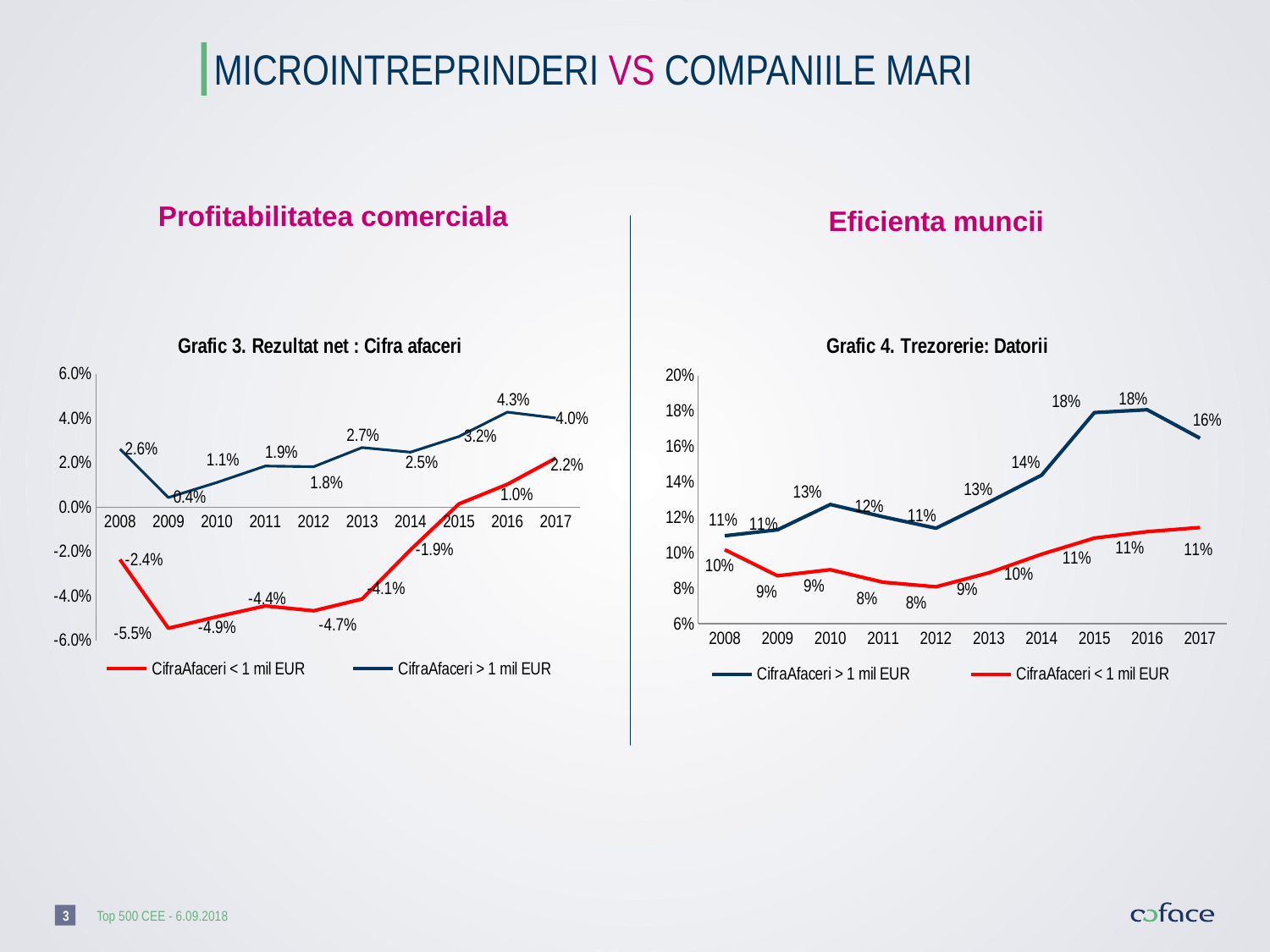
In the chart 'Grafic 4. Trezorerie: Datorii', what is the value for CifraAfaceri > 1 mil EUR in 2015? 18% In the chart 'Grafic 3. Rezultat net : Cifra afaceri', how many series does the legend list? 2 In the chart 'Grafic 4. Trezorerie: Datorii', what is the value for CifraAfaceri < 1 mil EUR in 2012? 8% In the chart 'Grafic 4. Trezorerie: Datorii', which series has the higher value in 2014? CifraAfaceri > 1 mil EUR In the chart 'Grafic 4. Trezorerie: Datorii', what is the difference between the two series in 2016? 7% What kind of chart is 'Grafic 3. Rezultat net : Cifra afaceri'? Line chart How many years are shown on the x axis of the chart 'Grafic 4. Trezorerie: Datorii'? 10 In the chart 'Grafic 3. Rezultat net : Cifra afaceri', which year has the lowest value for CifraAfaceri < 1 mil EUR? 2009 In the chart 'Grafic 3. Rezultat net : Cifra afaceri', what is the value for CifraAfaceri > 1 mil EUR in 2016? 4.3% In the chart 'Grafic 4. Trezorerie: Datorii', which colour is used for the CifraAfaceri < 1 mil EUR line? Red In the chart 'Grafic 3. Rezultat net : Cifra afaceri', what is the value for CifraAfaceri < 1 mil EUR in 2009? -5.5% In the chart 'Grafic 3. Rezultat net : Cifra afaceri', what is the difference between the 2017 values of CifraAfaceri > 1 mil EUR and CifraAfaceri < 1 mil EUR? 1.8%